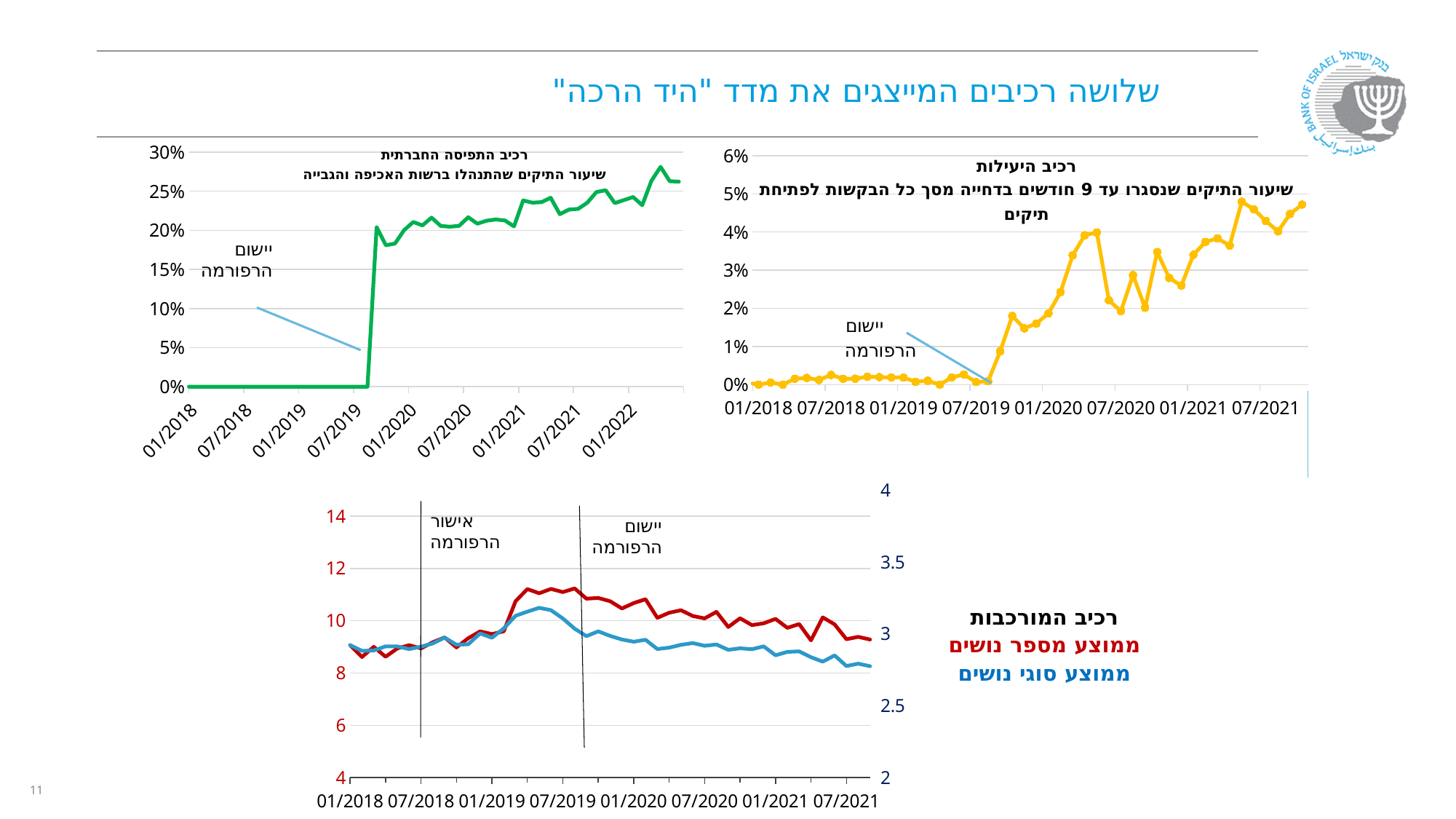
In the bottom chart (רכיב המורכבות), is the red line's value in 07/2019 greater or less than 10 on the left axis? greater In the top-right chart (רכיב היעילות), is the value in 07/2021 greater or less than 4%? greater In the top-right chart (רכיב היעילות), is the value in 01/2019 greater or less than 1%? less In the top-right chart (רכיב היעילות), do the values overall rise or fall from 01/2018 to 07/2021? rise How many charts are shown on the slide? 3 In the bottom chart (רכיב המורכבות), which series is drawn in red? ממוצע מספר נושים In the bottom chart (רכיב המורכבות), does the red line rise or fall from 07/2019 to 07/2021? fall How many series does the bottom chart (רכיב המורכבות) show? 2 In the top-left chart (רכיב התפיסה החברתית), what is the value in 01/2018? 0% What kind of chart is the top-left chart (רכיב התפיסה החברתית)? line chart